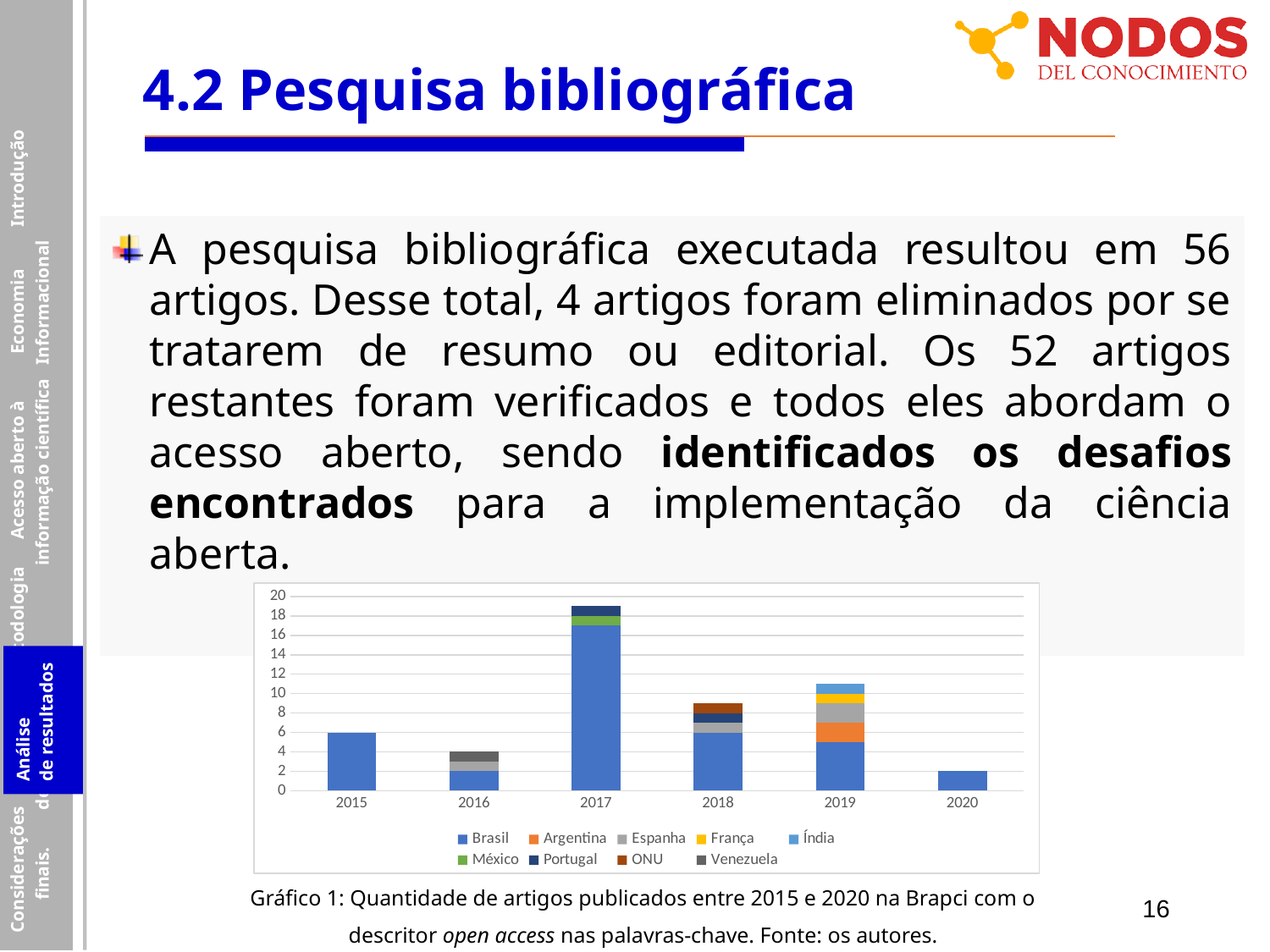
Is the total value of the bar for 2018 greater or less than 10? less Which year has the tallest bar in the chart? 2017 What is the value of the bar for 2015? 6 What kind of chart is shown on the slide? stacked bar chart Which year has the shortest bar in the chart? 2020 How many years are shown on the x axis of the chart? 6 Is the total value of the bar for 2019 greater or less than 10? greater Is the total value of the bar for 2017 greater or less than 18? greater How many series does the chart legend list? 9 Which series is listed first in the chart legend? Brasil Which bar is taller, 2018 or 2019? 2019 According to the caption, which database do the articles in the chart come from? Brapci